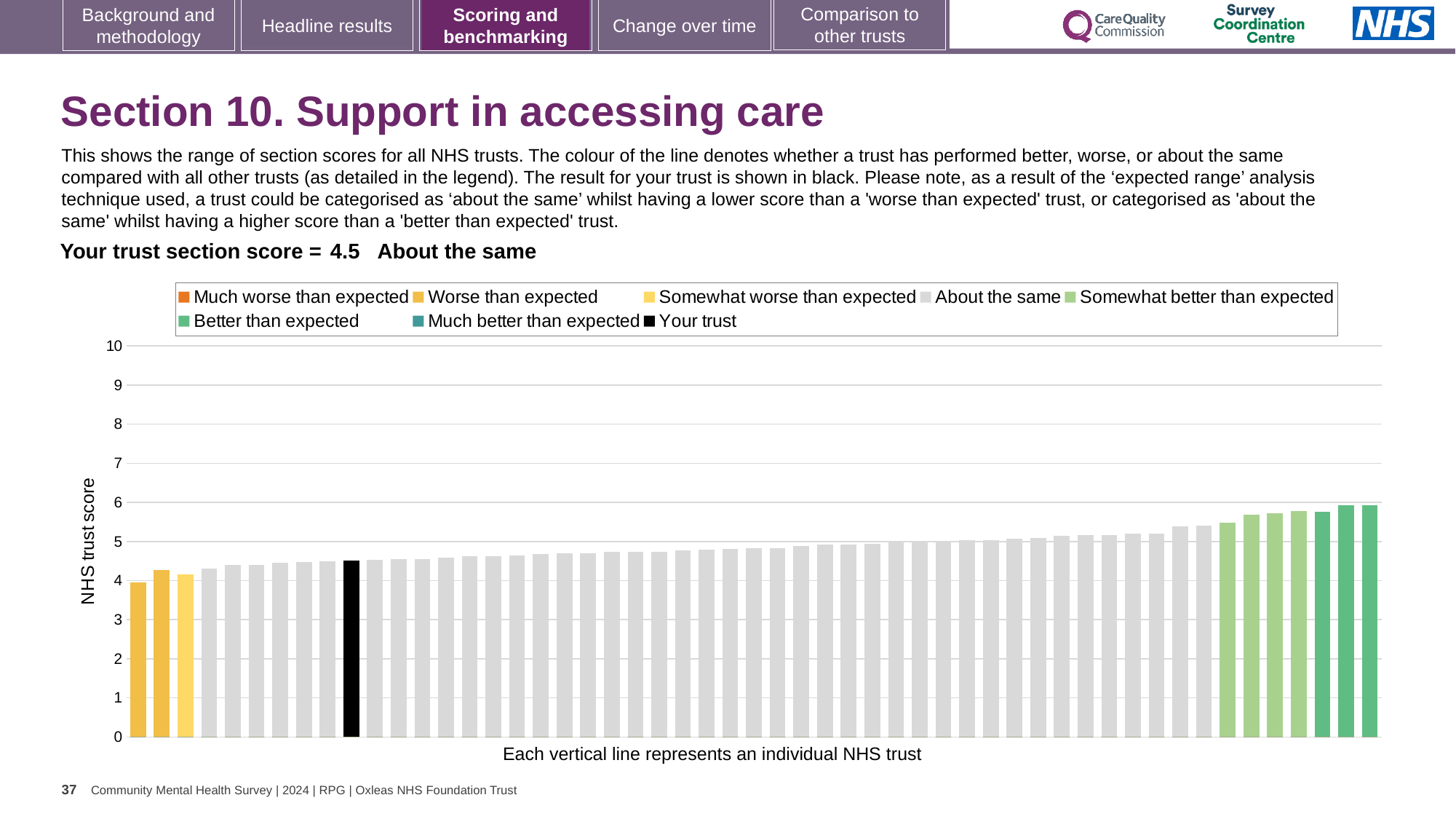
Is the value of the shortest bar in the chart greater or less than 3? greater Which performance category is the trust's section score assigned to? About the same What colour is the bar representing your trust? black How many entries does the chart legend list? 8 Is the value of the black 'Your trust' bar greater or less than 5? less What kind of chart is shown on the slide? bar chart How many bars are coloured in the 'Worse than expected' yellow colour? 2 Is the black 'Your trust' bar higher or lower than the rightmost bar in the chart? lower What is the label on the vertical axis of the chart? NHS trust score Do the bar values rise or fall from left to right along the x axis? rise What is the trust's section score shown on the slide? 4.5